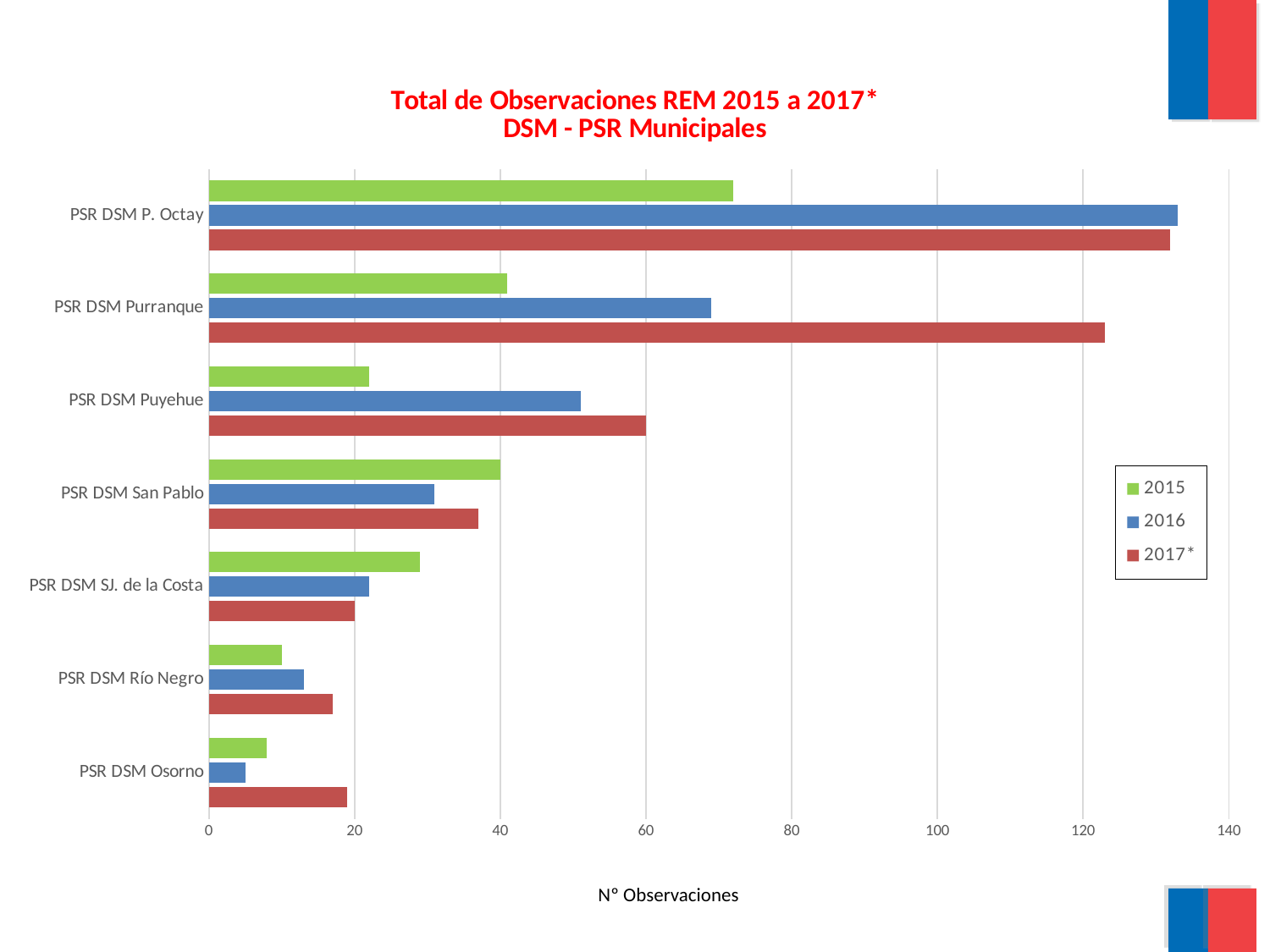
Which category has the highest value for 2017*? PSR DSM P. Octay What kind of chart is shown on the slide? bar chart Which category has the lowest value for 2016? PSR DSM Osorno Is the value for PSR DSM Osorno in 2016 greater or less than 20? less Is the value for PSR DSM Purranque in 2017* greater or less than 100? greater How many series does the legend list? 3 Which category has the highest value for 2016? PSR DSM P. Octay What is the label of the horizontal axis? N° Observaciones How many PSR DSM categories are shown on the chart? 7 For PSR DSM Osorno, which is larger: the 2015 value or the 2017* value? 2017* For PSR DSM San Pablo, which is larger: the 2015 value or the 2016 value? 2015 Is the value for PSR DSM P. Octay in 2015 greater or less than 60? greater